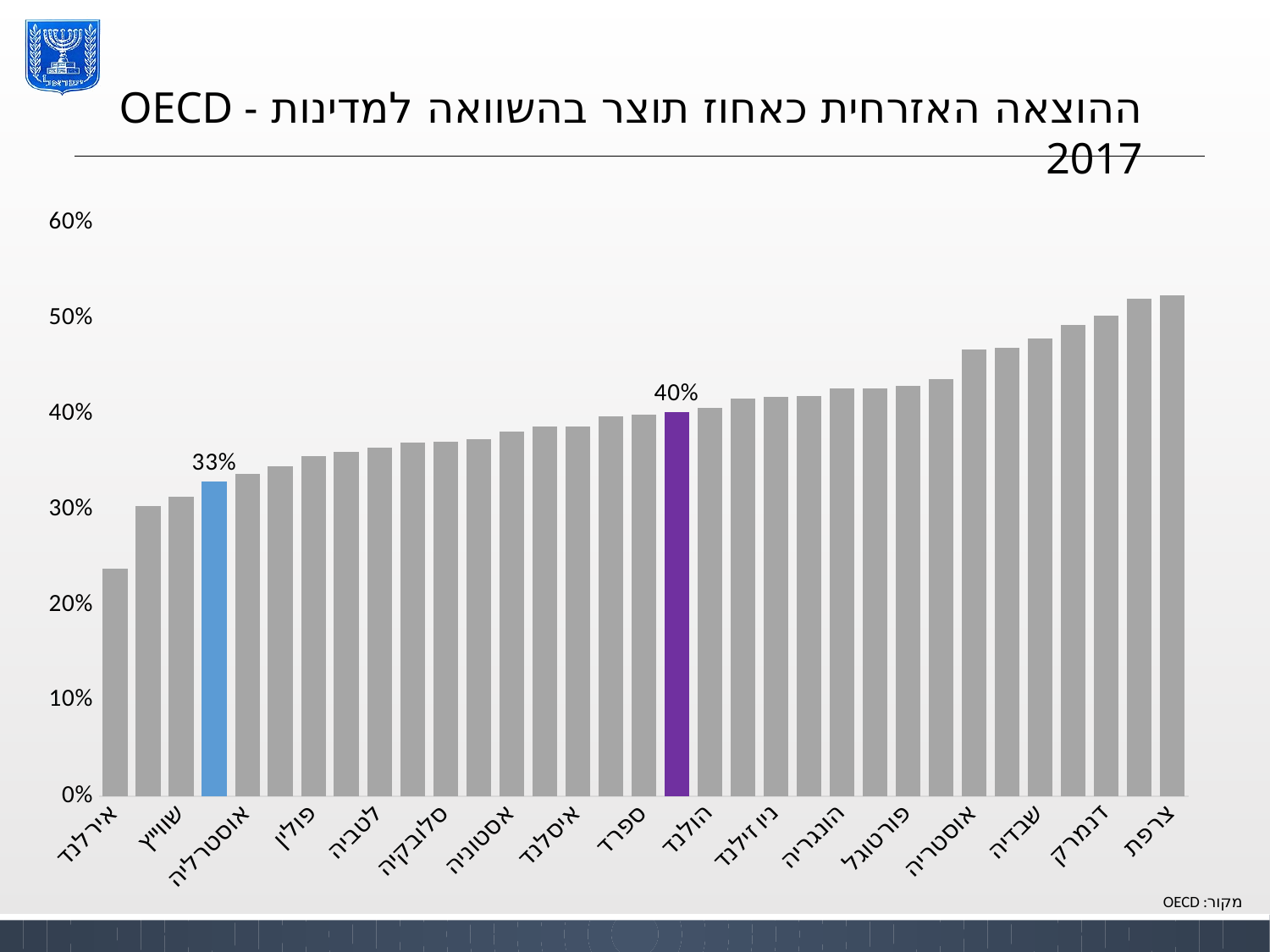
Do the bar values rise or fall from left to right along the x axis? rise Is the value for הונגריה greater or less than 40%? greater Which is larger, the blue bar or the purple bar? the purple bar What value is printed on the purple bar? 40% Which country has the lowest value in the chart? אירלנד Is the value for אירלנד greater or less than 30%? less Is the value for צרפת greater or less than 50%? greater What kind of chart is shown on the slide? bar chart What source is cited at the bottom of the slide? OECD Which country has the highest value in the chart? צרפת What is the difference between the purple bar (40%) and the blue bar (33%)? 7% What value is printed on the blue bar? 33%